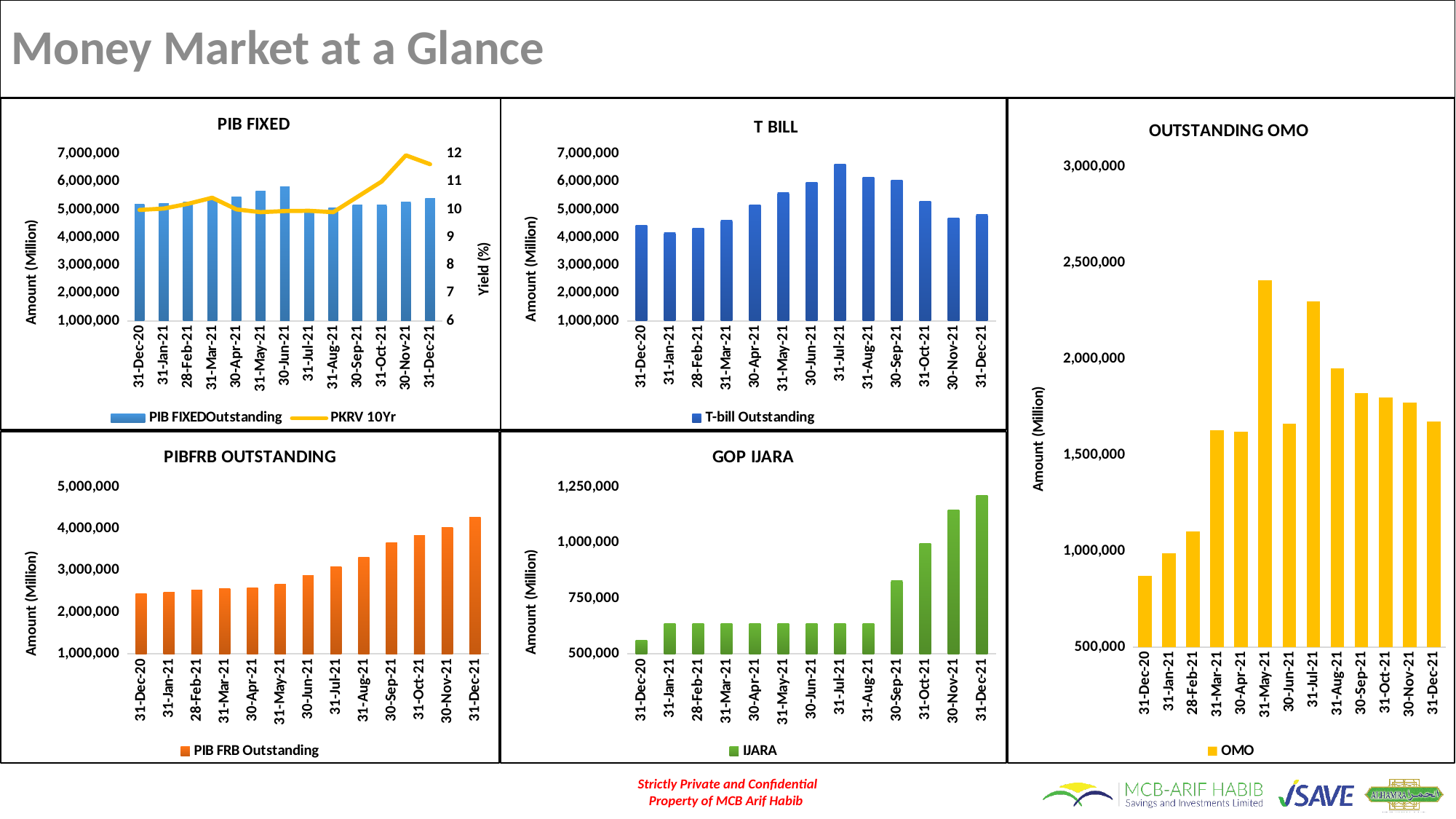
In the GOP IJARA chart, which date has the highest IJARA value? 31-Dec-21 In the PIBFRB OUTSTANDING chart, do the values generally rise or fall from 31-Dec-20 to 31-Dec-21? rise In the T BILL chart, which date has the highest T-bill Outstanding value? 31-Jul-21 In the PIBFRB OUTSTANDING chart, is the value for 31-Dec-21 greater or less than 4,000,000? greater In the T BILL chart, is the value for 31-Jul-21 greater or less than 6,000,000? greater In the GOP IJARA chart, which date has the lowest IJARA value? 31-Dec-20 In the PIB FIXED chart, what is the name of the series plotted as a line? PKRV 10Yr In the T BILL chart, which date has the lowest T-bill Outstanding value? 31-Jan-21 How many series does the legend of the PIB FIXED chart list? 2 How many dates are plotted on the x axis of the T BILL chart? 13 In the OUTSTANDING OMO chart, which date has the highest OMO value? 31-May-21 In the OUTSTANDING OMO chart, which date has the lowest OMO value? 31-Dec-20